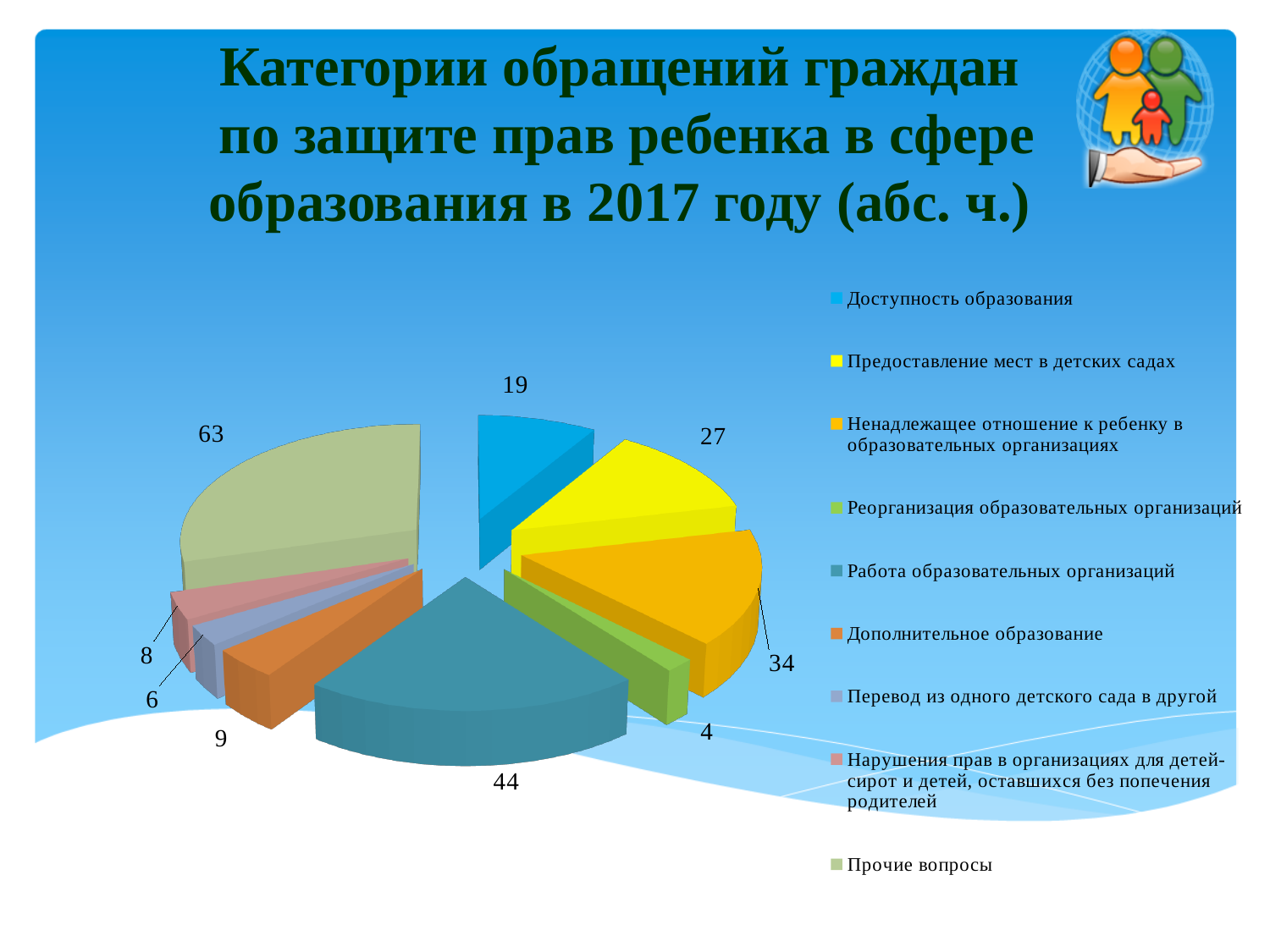
Which is larger: "Предоставление мест в детских садах" or "Дополнительное образование"? Предоставление мест в детских садах What year does the chart title say the data refers to? 2017 What is the value for "Перевод из одного детского сада в другой"? 6 What is the difference between the values for "Прочие вопросы" and "Работа образовательных организаций"? 19 How many categories does the pie chart have? 9 What is the value for "Ненадлежащее отношение к ребенку в образовательных организациях"? 34 How many entries does the legend list? 9 What is the value for "Работа образовательных организаций"? 44 Which category has the largest value? Прочие вопросы What kind of chart is shown on the slide? pie chart What is the value for "Доступность образования"? 19 Which category has the smallest value? Реорганизация образовательных организаций